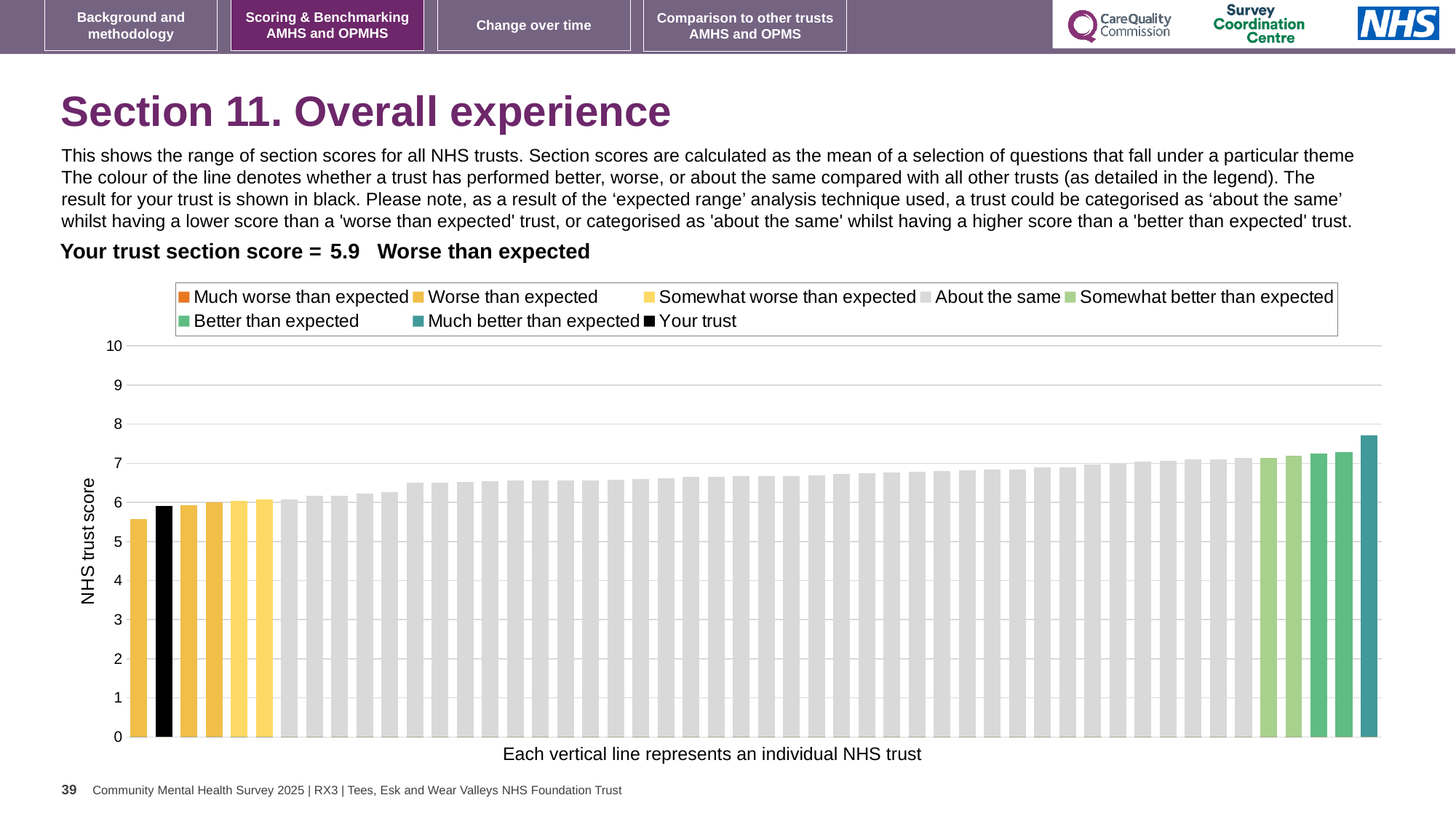
What colour is used for 'Your trust' in the chart? Black What kind of chart is shown on the slide? Bar chart What is the label on the y axis of the chart? NHS trust score Is the value of the tallest bar greater or less than 7? greater Which legend category does your trust fall into according to the slide? Worse than expected Which legend category does the tallest bar belong to? Much better than expected Is the value of the shortest bar greater or less than 6? less How many entries does the chart legend list? 8 Is the value of the black bar (your trust) greater or less than 5? greater Do the bar values rise or fall from left to right along the x axis? rise Which legend category does the shortest bar belong to? Worse than expected What is the section score for your trust shown on the slide? 5.9